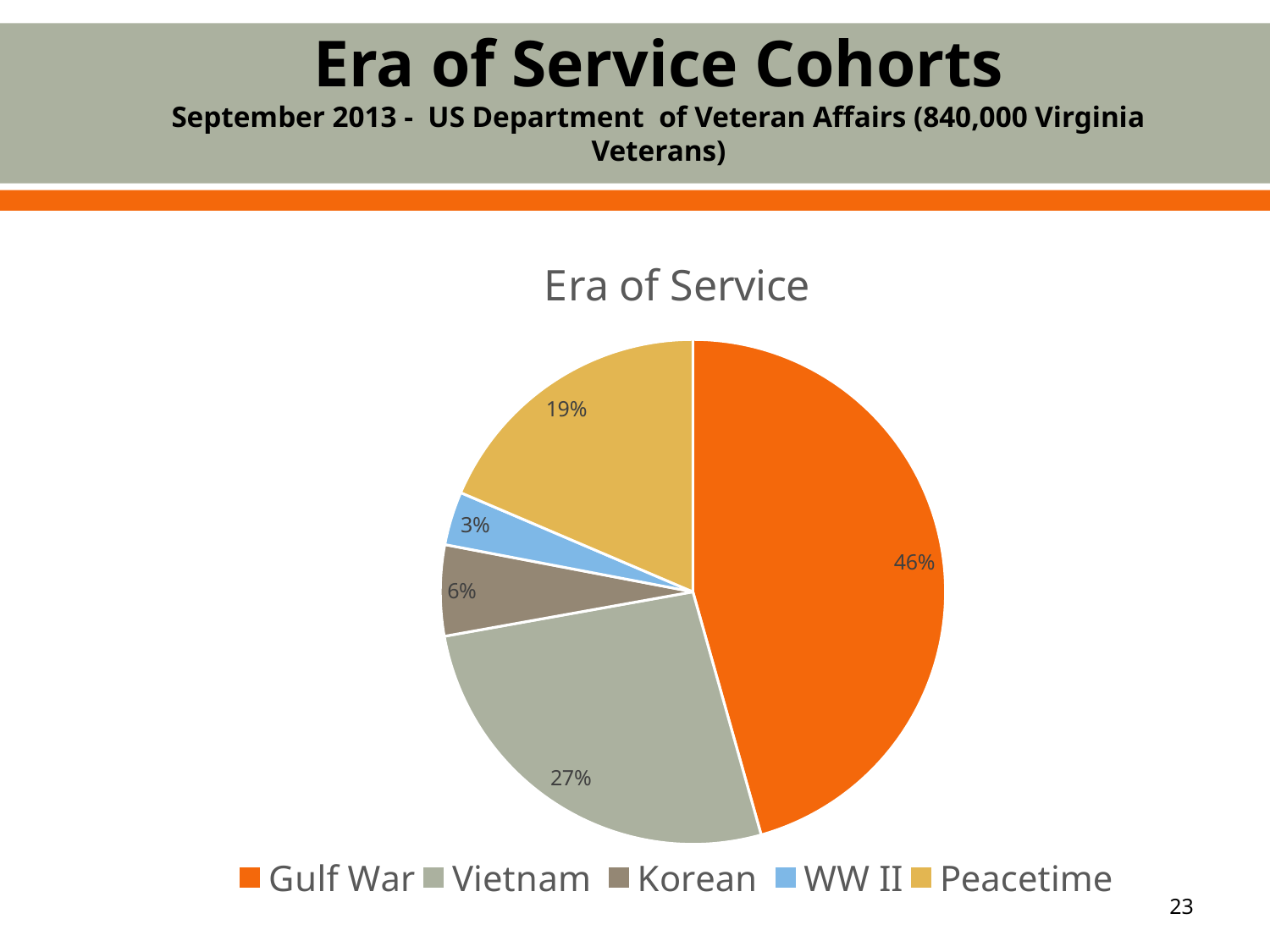
What kind of chart is shown on the slide? Pie chart What percentage of the pie is WW II? 3% Which slice is larger, Peacetime or Korean? Peacetime How many categories does the legend list? 5 What percentage of the pie is Vietnam? 27% Which era of service has the largest share of the pie? Gulf War What is the title of the chart? Era of Service What percentage of the pie is Peacetime? 19% What percentage of the pie is Korean? 6% What is the difference in percentage points between the Gulf War and Vietnam slices? 19 What percentage of the pie is Gulf War? 46% Which era of service has the smallest share of the pie? WW II